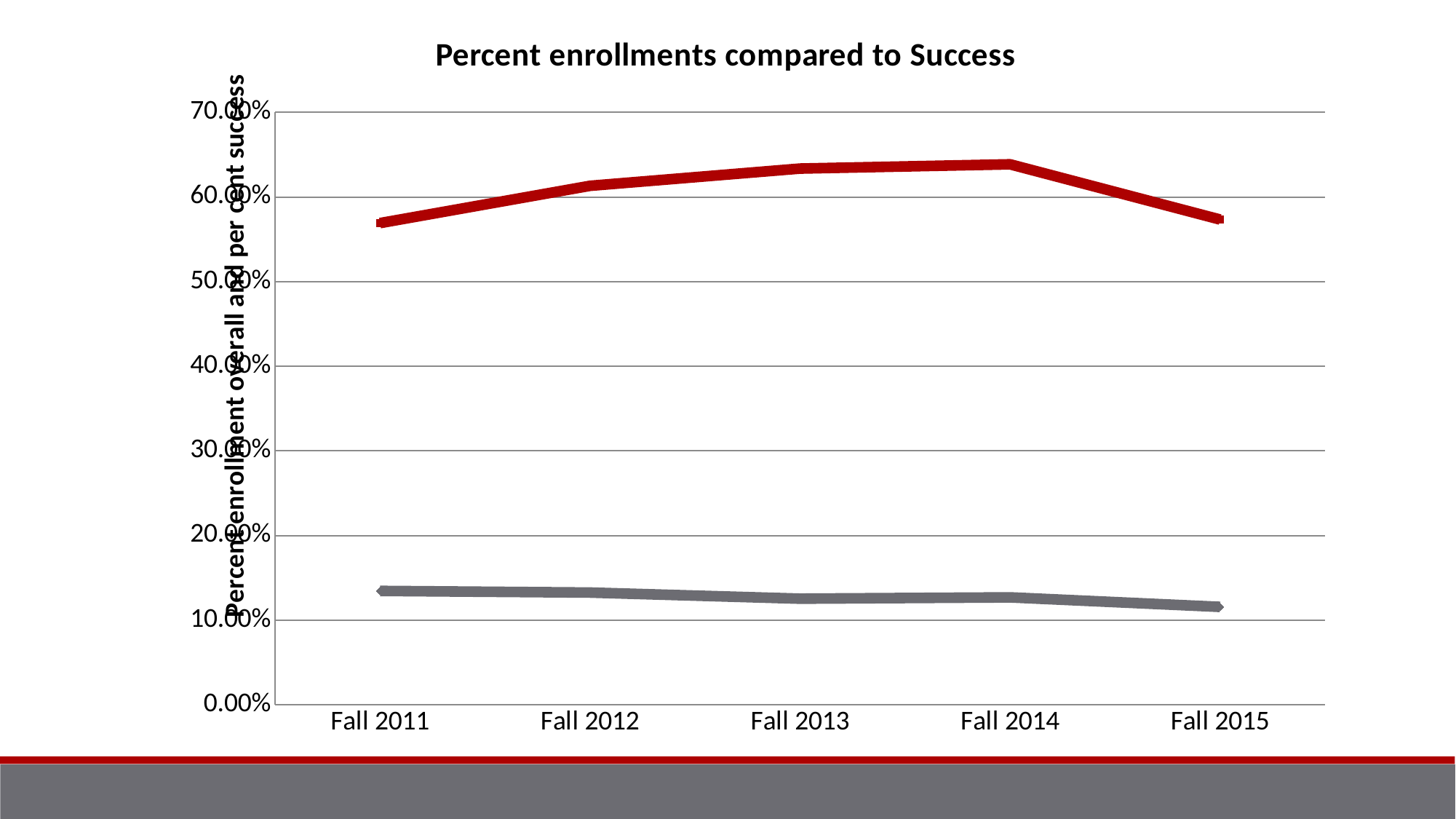
What is the title of the chart? Percent enrollments compared to Success What is the label of the vertical axis? Percent enrollment overall and per cent success What kind of chart is shown on the slide? line chart At which time point does the gray line reach its lowest value? Fall 2015 How many time points are plotted along the x axis? 5 Is the value of the gray line at Fall 2013 greater or less than 20.00%? less Which line has the higher value at Fall 2013, the red line or the gray line? the red line Is the value of the gray line at Fall 2011 greater or less than 10.00%? greater Is the value of the red line at Fall 2011 greater or less than 60.00%? less Does the red line rise or fall between Fall 2014 and Fall 2015? fall Does the gray line generally rise or fall from Fall 2011 to Fall 2015? fall